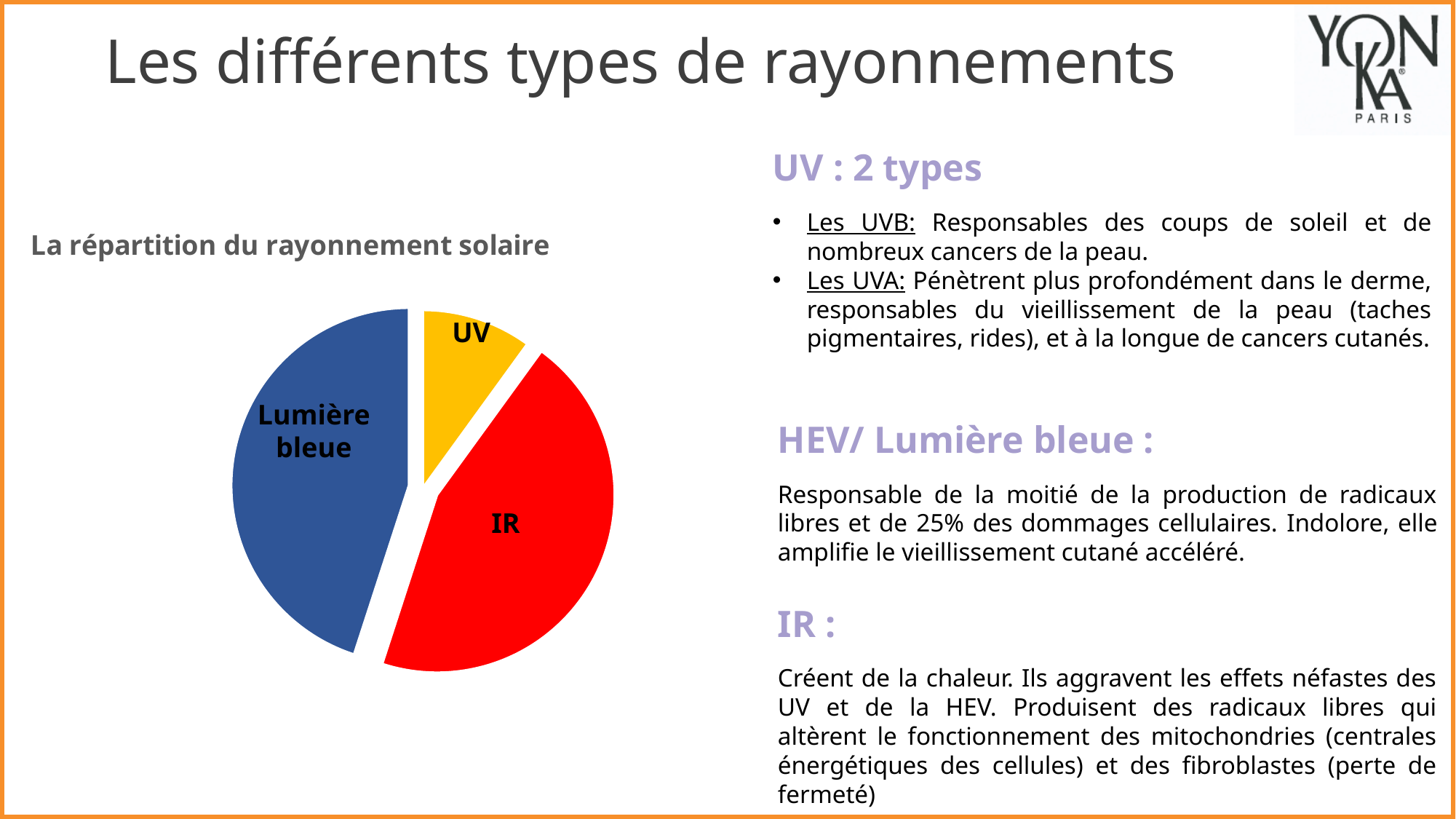
What colour is the IR slice of the pie chart? red How many slices does the pie chart have? 3 What kind of chart is shown on the slide? pie chart Which slice is larger in the pie chart, UV or Lumière bleue? Lumière bleue Which slice is smaller in the pie chart, UV or IR? UV What is the title of the pie chart? La répartition du rayonnement solaire Which slice of the pie chart is the smallest? UV